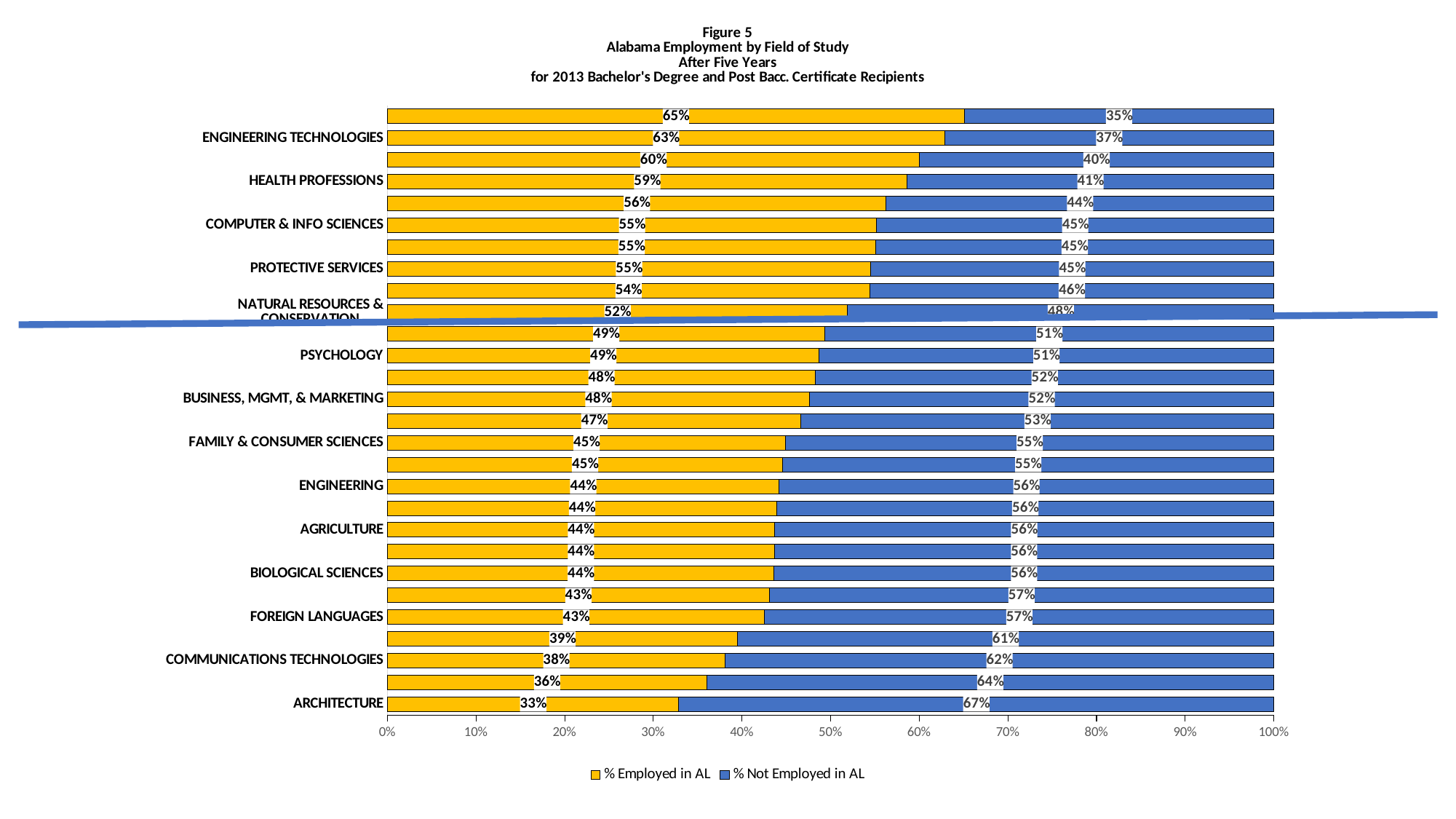
What is the % Employed in AL value for ARCHITECTURE? 33% Which labeled field of study has the highest % Not Employed in AL? ARCHITECTURE What is the % Not Employed in AL value for COMMUNICATIONS TECHNOLOGIES? 62% What is the % Not Employed in AL value for HEALTH PROFESSIONS? 41% What is the % Employed in AL value for ENGINEERING TECHNOLOGIES? 63% Which has a higher % Employed in AL, HEALTH PROFESSIONS or PSYCHOLOGY? HEALTH PROFESSIONS What is the total of the stacked bar for FOREIGN LANGUAGES? 100% What is the difference in % Employed in AL between ENGINEERING TECHNOLOGIES and ARCHITECTURE? 30 percentage points Which labeled field of study has the lowest % Employed in AL? ARCHITECTURE How many series does the legend list? 2 What kind of chart is shown on the slide? Stacked bar chart What are the two series named in the legend? % Employed in AL and % Not Employed in AL